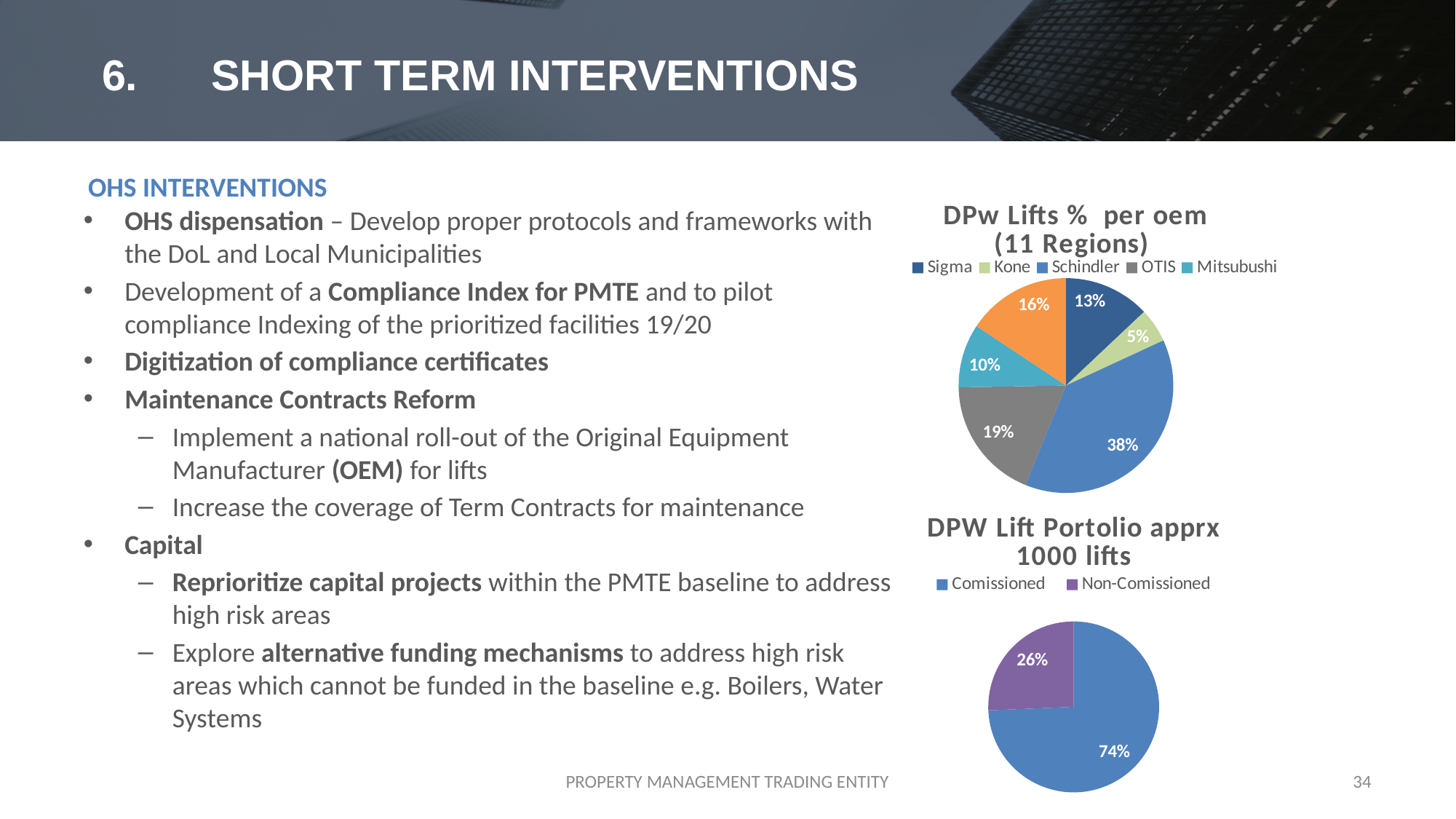
How many entries does the legend of the 'DPw Lifts % per oem (11 Regions)' chart list? 5 In the 'DPW Lift Portolio apprx 1000 lifts' chart, what is the difference between the Comissioned and Non-Comissioned shares? 48% In the 'DPw Lifts % per oem (11 Regions)' chart, what share does Schindler have? 38% In the 'DPw Lifts % per oem (11 Regions)' chart, which is larger, the Sigma share or the Mitsubushi share? Sigma In the 'DPw Lifts % per oem (11 Regions)' chart, what share does Sigma have? 13% In the 'DPw Lifts % per oem (11 Regions)' chart, what share does OTIS have? 19% In the 'DPW Lift Portolio apprx 1000 lifts' chart, what share is Non-Comissioned? 26% In the 'DPw Lifts % per oem (11 Regions)' chart, which OEM has the smallest share? Kone What kind of chart is 'DPW Lift Portolio apprx 1000 lifts'? Pie chart In the 'DPw Lifts % per oem (11 Regions)' chart, what is the difference between the Schindler and OTIS shares? 19% In the 'DPw Lifts % per oem (11 Regions)' chart, which OEM has the largest share? Schindler In the 'DPw Lifts % per oem (11 Regions)' chart, what share does Kone have? 5%